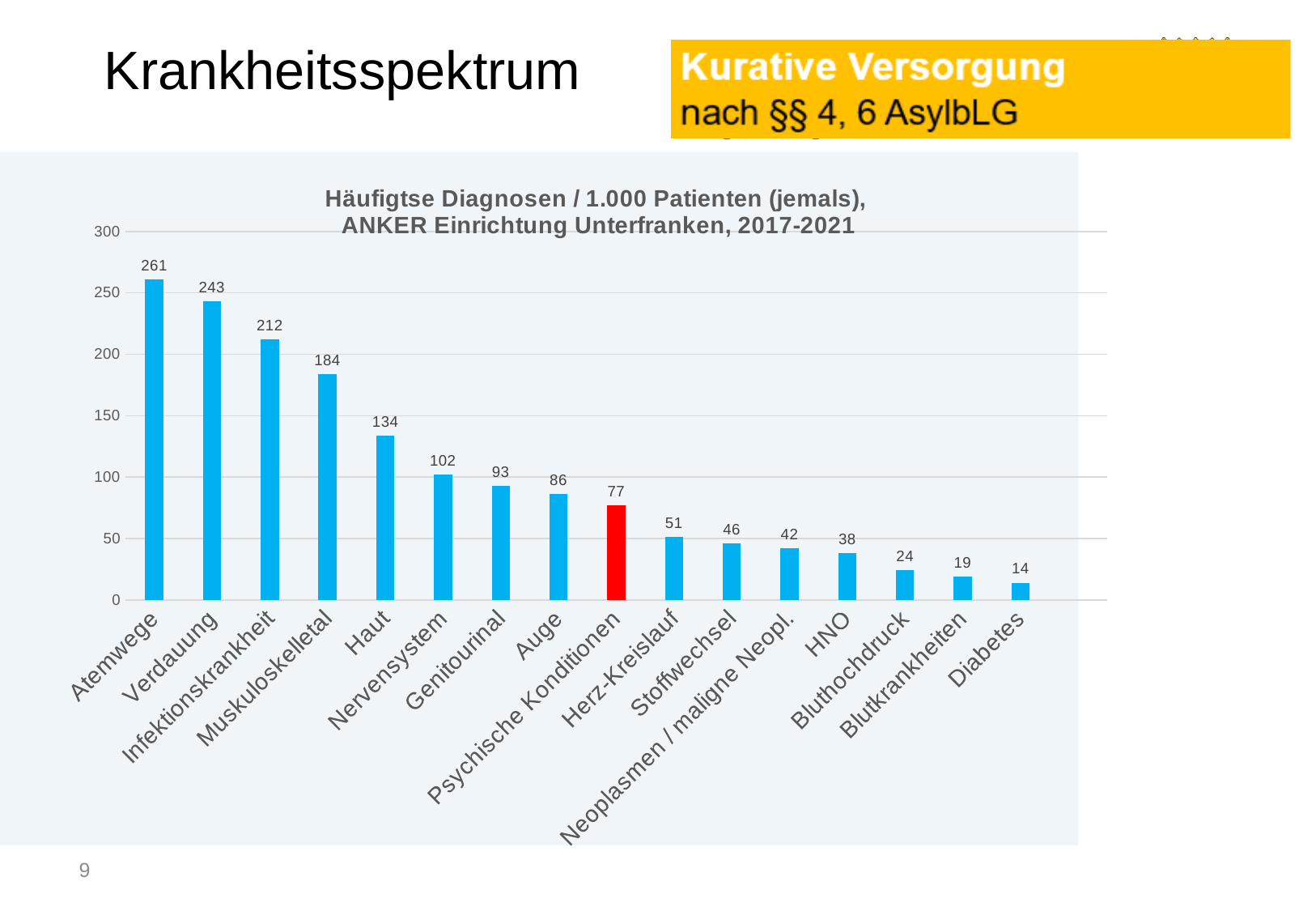
What is the difference between the values for Haut and Nervensystem? 32 What is the value for Psychische Konditionen? 77 What kind of chart is shown on the slide? Bar chart How many categories are shown on the x axis? 16 Which is larger, the value for Infektionskrankheit or the value for Muskuloskeletal? Infektionskrankheit What is the value for HNO? 38 What is the value for Atemwege? 261 Which bar is coloured red instead of blue? Psychische Konditionen What is the difference between the values for Atemwege and Verdauung? 18 Which category has the lowest value? Diabetes Do the values rise or fall from left to right along the x axis? Fall Which category has the highest value? Atemwege